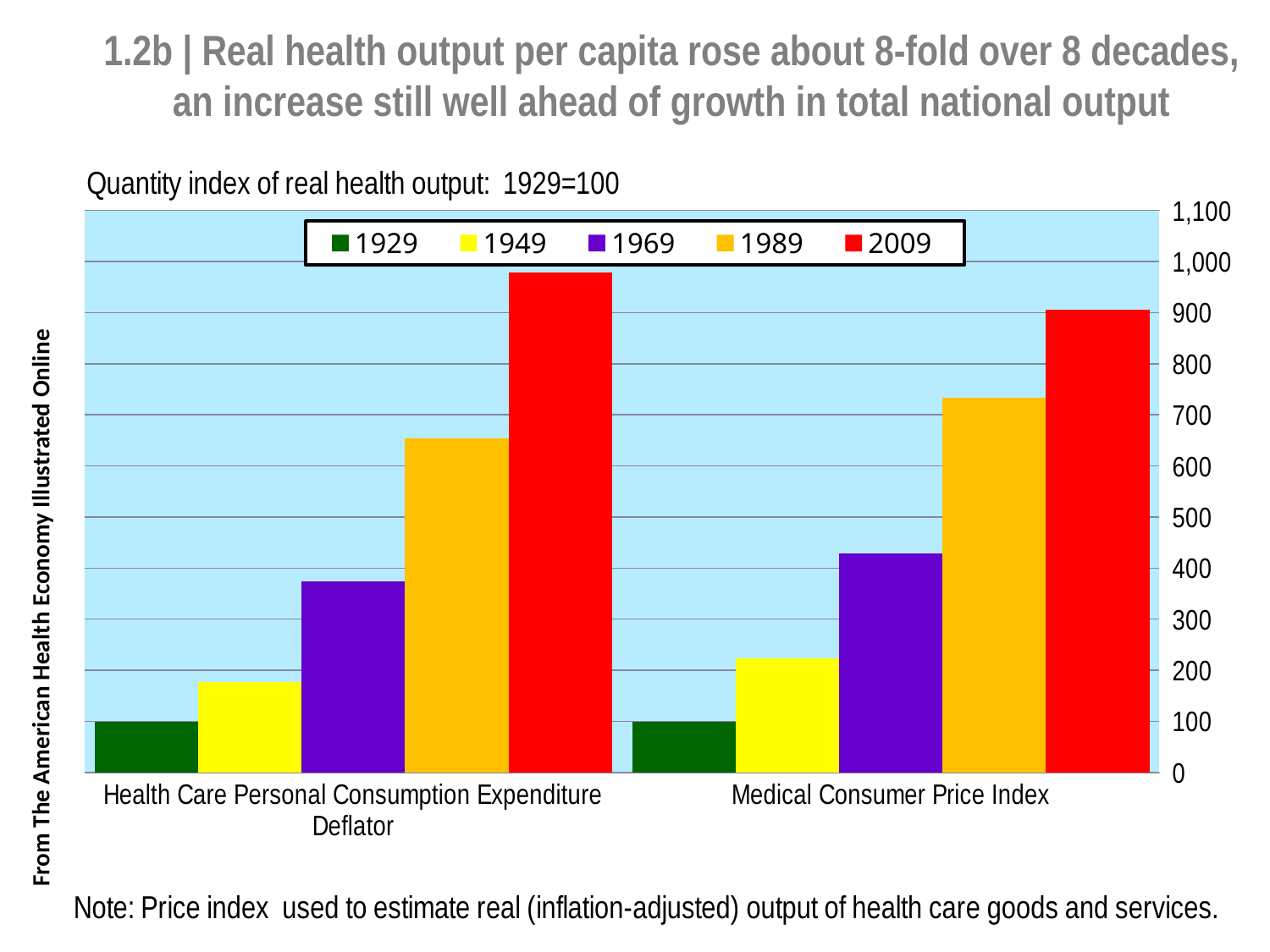
What kind of chart is shown on the slide? bar chart What is the value of the 1929 bar for Medical Consumer Price Index? 100 Which year has the highest value for Medical Consumer Price Index? 2009 Which is larger: the 2009 value for Health Care Personal Consumption Expenditure Deflator or the 2009 value for Medical Consumer Price Index? Health Care Personal Consumption Expenditure Deflator What is the value of the 1929 bar for Health Care Personal Consumption Expenditure Deflator? 100 Is the 2009 value for Health Care Personal Consumption Expenditure Deflator greater or less than 900? greater How many categories are shown on the x axis? 2 Is the 1989 value for Medical Consumer Price Index greater or less than 700? greater How many series does the legend list? 5 Which colour represents the 1989 series in the legend? orange Is the 1969 value for Health Care Personal Consumption Expenditure Deflator greater or less than 400? less Do the values for Medical Consumer Price Index rise or fall from 1929 to 2009? rise